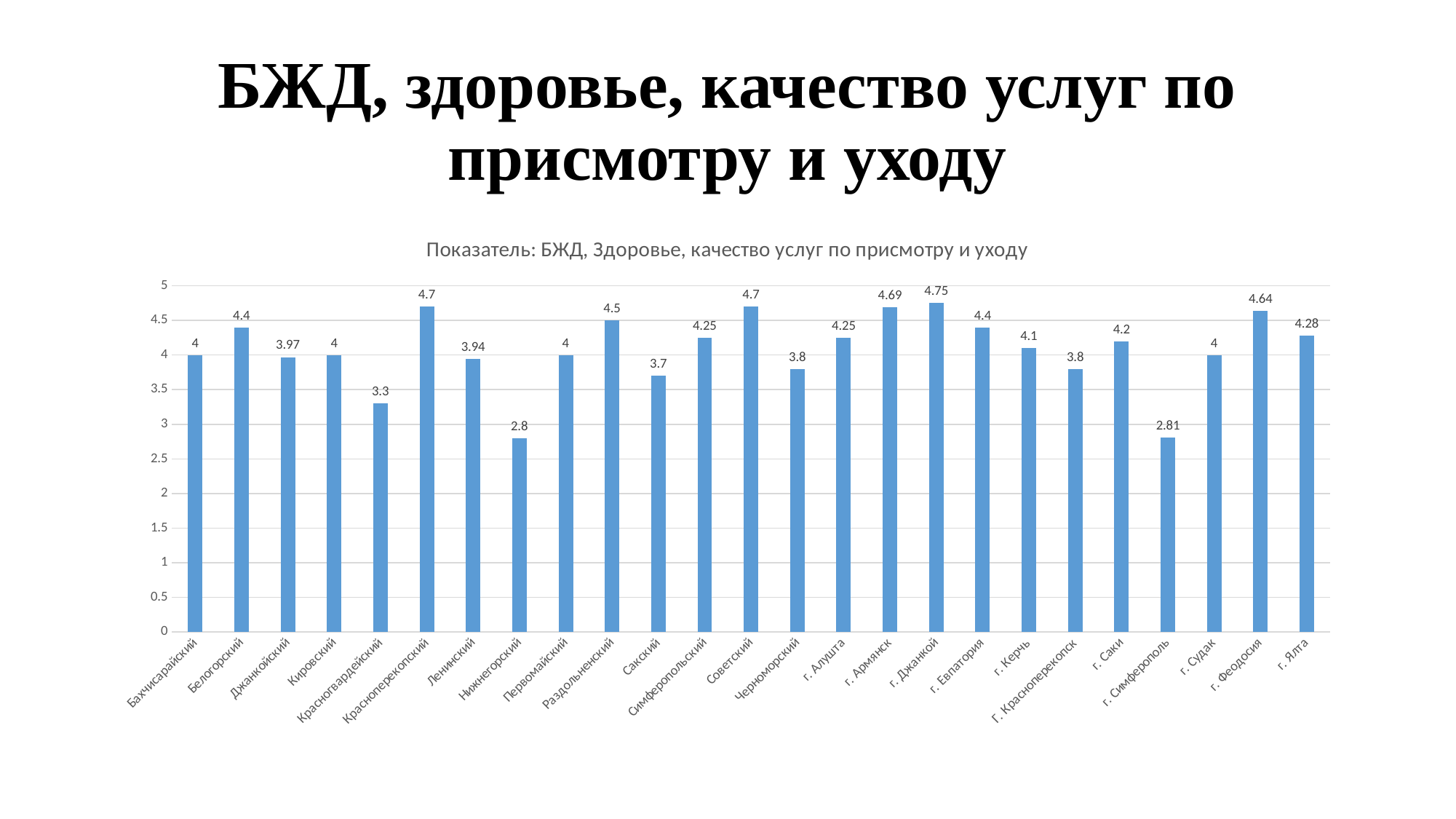
What is the value for г. Феодосия? 4.64 Which category has the lowest value? Нижнегорский How many categories are shown on the x axis? 25 What kind of chart is shown on the slide? Bar chart What is the difference between the values for Белогорский and Сакский? 0.7 Which is larger, the value for г. Армянск or the value for г. Ялта? г. Армянск What is the difference between the values for г. Джанкой and Нижнегорский? 1.95 Which category has the highest value? г. Джанкой What is the title of the chart? Показатель: БЖД, Здоровье, качество услуг по присмотру и уходу What is the value for г. Симферополь? 2.81 What is the value for Красноперекопский? 4.7 What is the value for Красногвардейский? 3.3